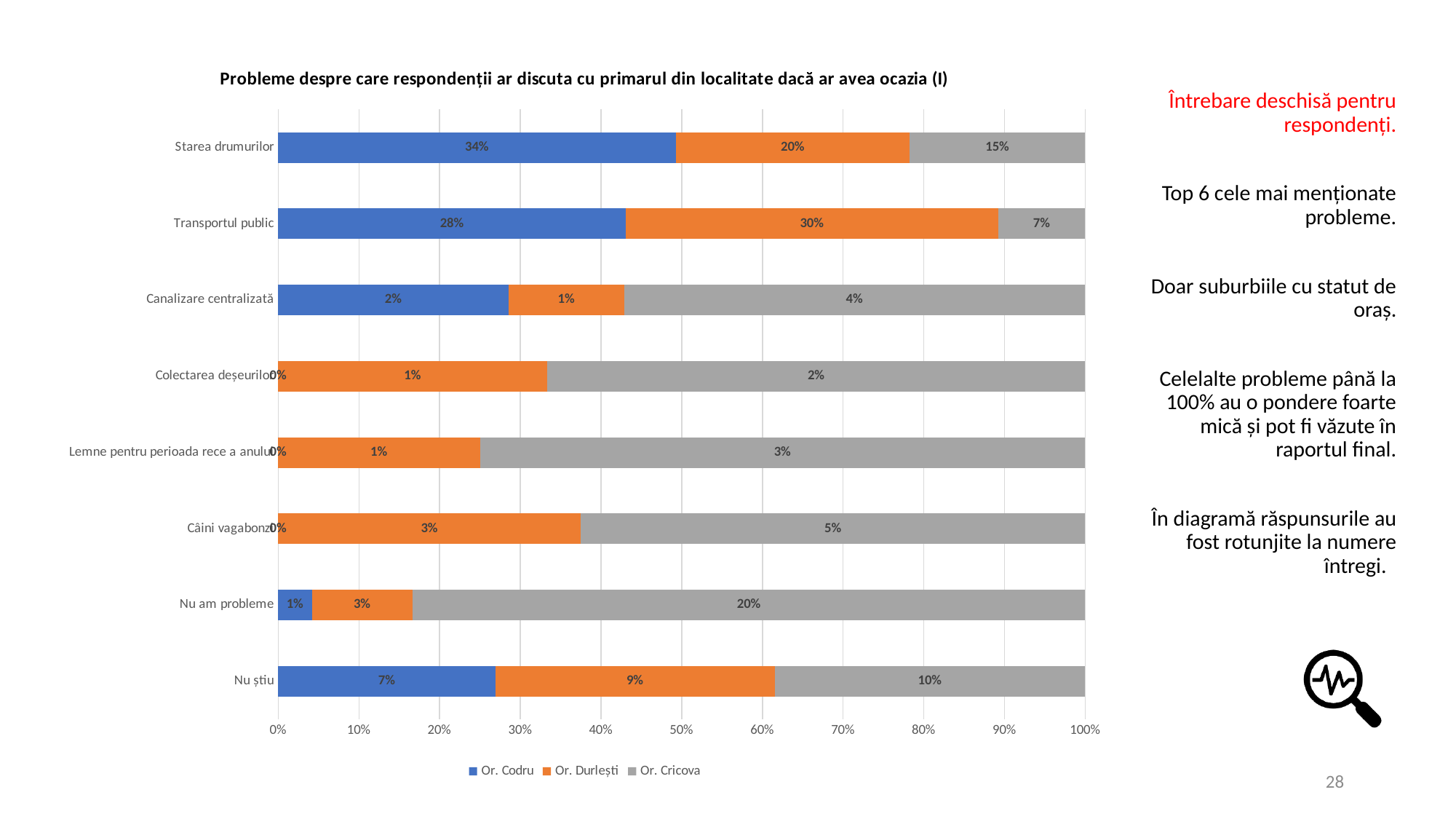
What type of chart is shown on the slide? Stacked bar chart Which series is represented by the orange colour in the chart? Or. Durlești How many series does the chart legend list? 3 What is the difference between the Or. Codru and Or. Cricova labels for 'Starea drumurilor'? 19% What percentage is shown for Or. Codru in the 'Starea drumurilor' category? 34% How many problem categories are listed on the vertical axis of the chart? 8 What value is labelled for Or. Cricova in the 'Câini vagabonzi' category? 5% For 'Nu știu', which is larger: the Or. Durlești value or the Or. Codru value? Or. Durlești Which category has the highest labelled value for Or. Codru? Starea drumurilor Which category has the highest labelled value for Or. Durlești? Transportul public What percentage is shown for Or. Durlești in the 'Transportul public' category? 30% What value is labelled for Or. Cricova in the 'Nu am probleme' category? 20%